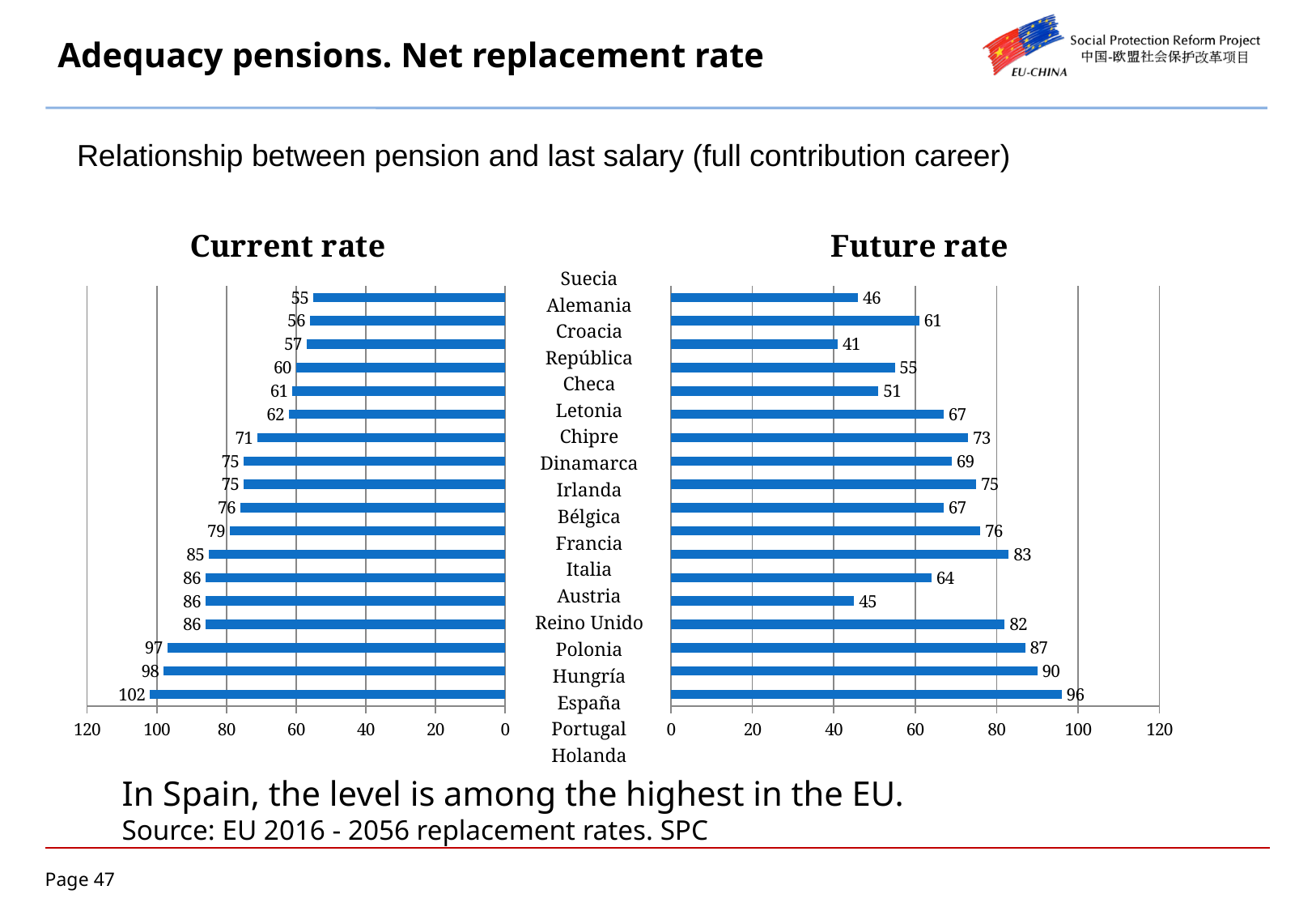
In the Current rate chart, what is the highest value shown? 102 How many bars are plotted in the Current rate chart? 18 In the Current rate chart, what is the difference between the highest and lowest values? 47 In the Future rate chart, what is the highest value shown? 96 In the Current rate chart, how many bars have a value greater than 100? 1 In the Current rate chart, what is the lowest value shown? 55 How many bars are plotted in the Future rate chart? 18 In the Future rate chart, what is the lowest value shown? 41 What kind of chart is the Current rate chart? bar chart What is the maximum value shown on the horizontal axis of the Future rate chart? 120 Which chart has the larger maximum value, Current rate or Future rate? Current rate In the Future rate chart, what is the difference between the highest and lowest values? 55